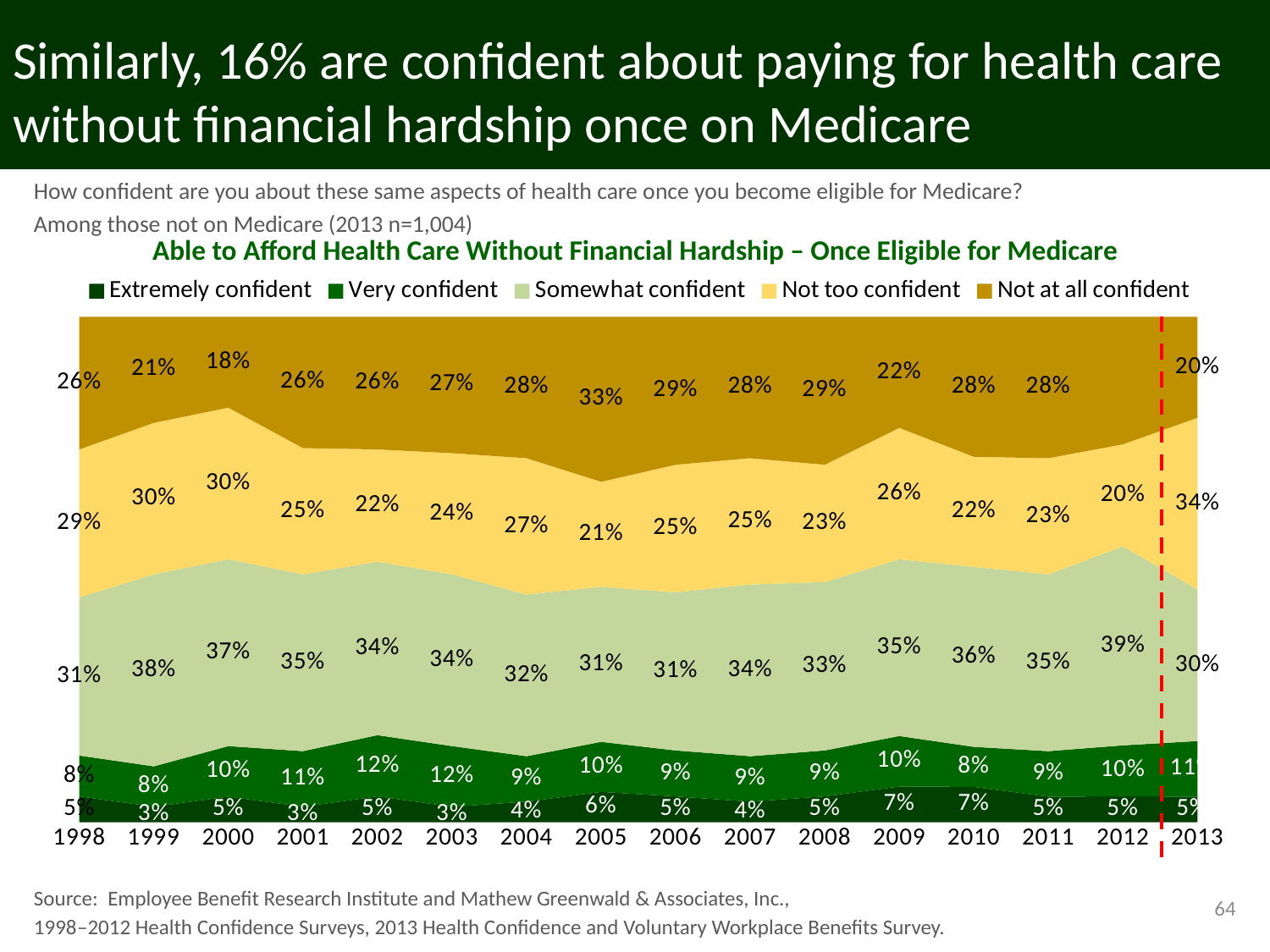
Which is larger, the Extremely confident value in 2009 or in 2011? 2009 In which year is the Somewhat confident value lowest? 2013 What is the value for Not too confident in 2013? 34% What is the value for Very confident in 2002? 12% How many series does the legend list? 5 What is the title of the chart? Able to Afford Health Care Without Financial Hardship – Once Eligible for Medicare What kind of chart is shown on the slide? Stacked area chart What is the value for Not at all confident in 2005? 33% In which year is the Not at all confident value highest? 2005 What is the value for Somewhat confident in 2012? 39% What is the difference between the Not too confident values in 2013 and 2012? 14 percentage points How many years are plotted along the x axis? 16